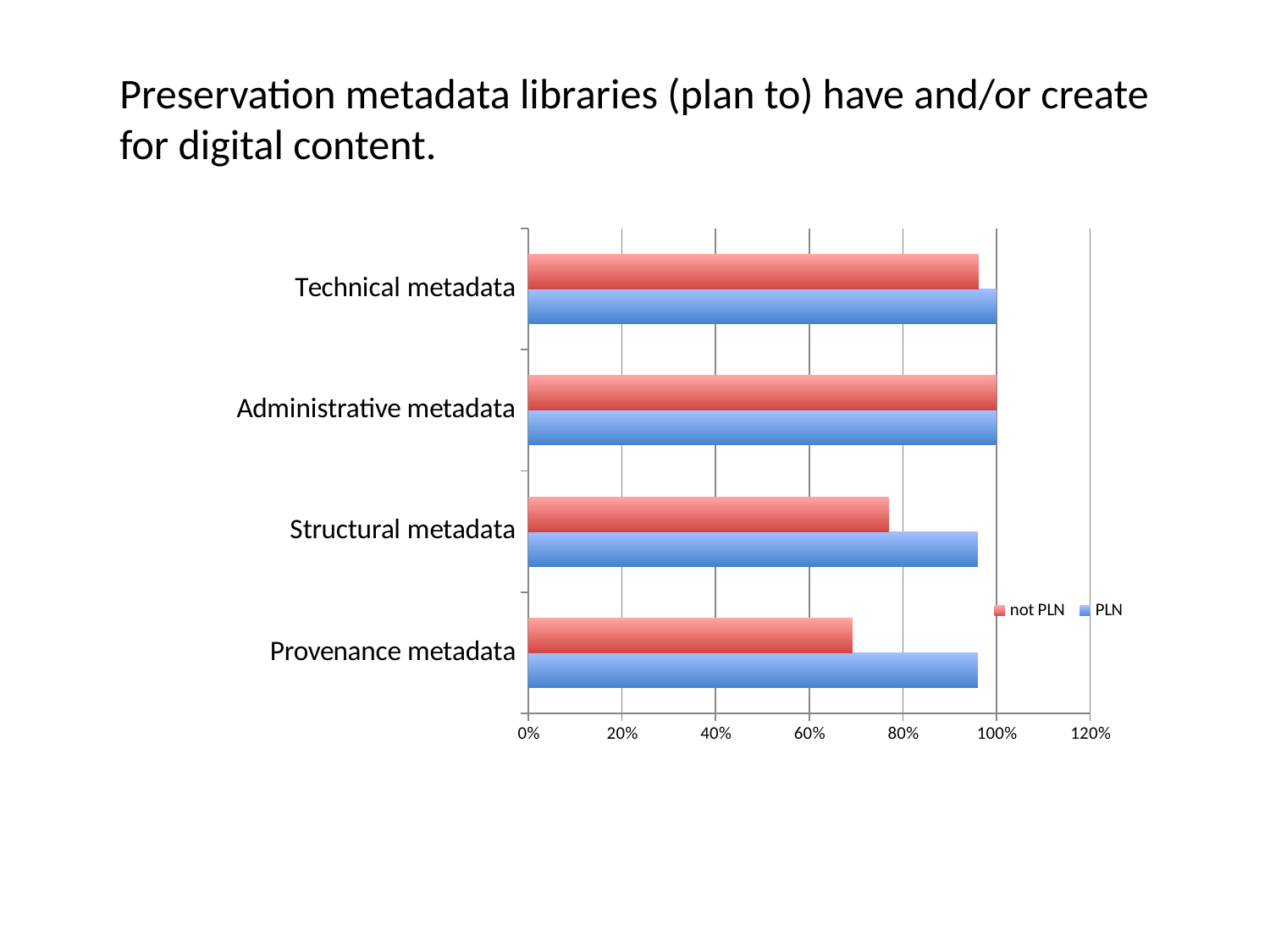
What kind of chart is shown on the slide? bar chart Is the not PLN value for Provenance metadata greater or less than 80%? less What is the PLN value for Administrative metadata? 100% Which category has the lowest not PLN value? Provenance metadata Is the not PLN value for Structural metadata greater or less than 60%? greater How many categories are shown on the chart? 4 What is the not PLN value for Administrative metadata? 100% How many series does the legend list? 2 What are the two series named in the legend? not PLN and PLN For Provenance metadata, which is larger: the PLN value or the not PLN value? PLN Is the PLN value for Structural metadata greater or less than 80%? greater What is the PLN value for Technical metadata? 100%